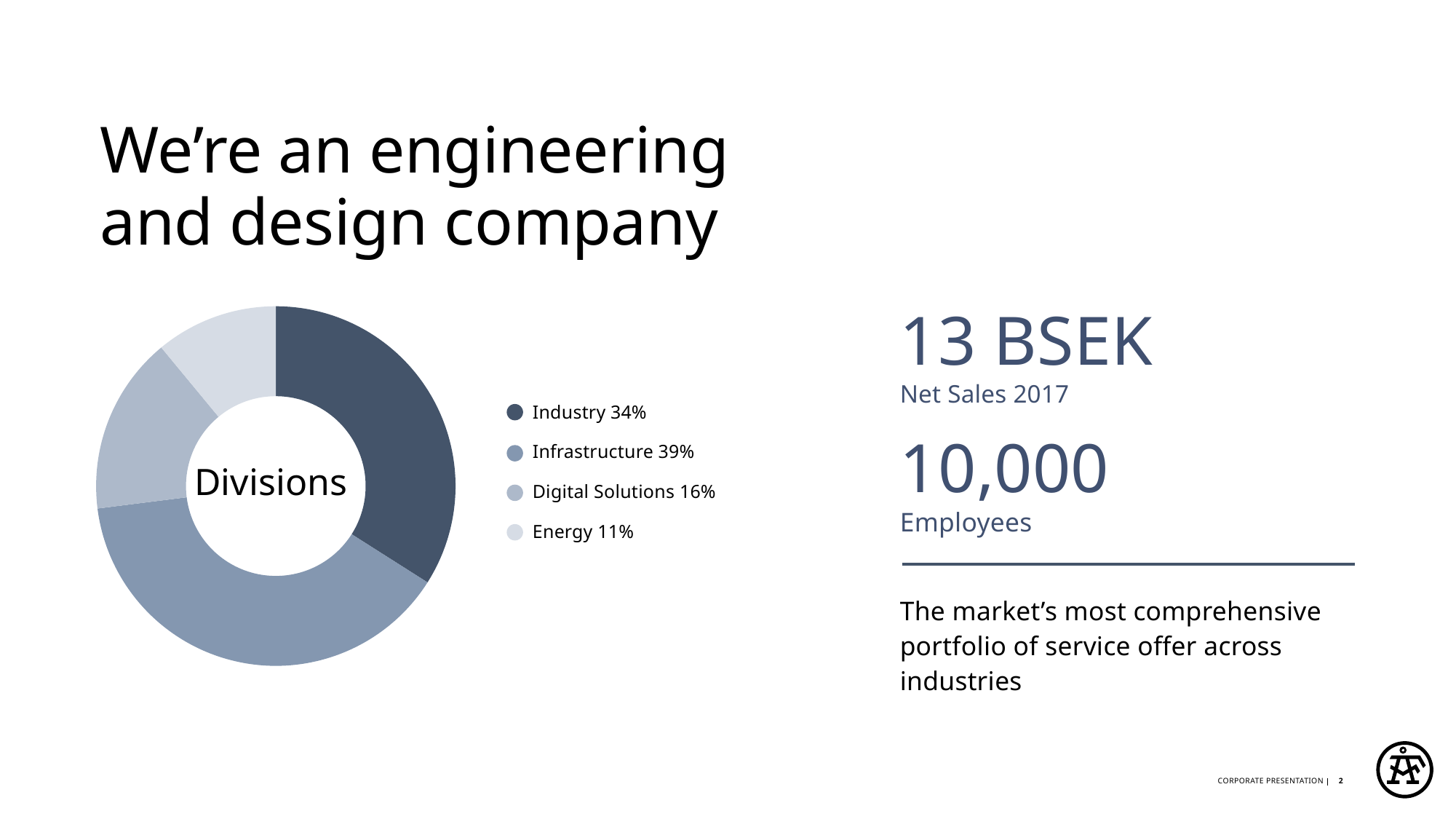
Which division has the largest share in the Divisions chart? Infrastructure What share of the Divisions chart does Energy account for? 11% What kind of chart is the Divisions chart? Doughnut chart What is the difference in share between Infrastructure and Industry in the Divisions chart? 5% How many divisions are shown in the Divisions chart? 4 Which division has the smallest share in the Divisions chart? Energy What text is shown in the centre of the doughnut chart? Divisions What share of the Divisions chart does Industry account for? 34% What is the combined share of Industry and Infrastructure in the Divisions chart? 73% What share of the Divisions chart does Digital Solutions account for? 16% Which has a larger share in the Divisions chart, Digital Solutions or Energy? Digital Solutions What share of the Divisions chart does Infrastructure account for? 39%